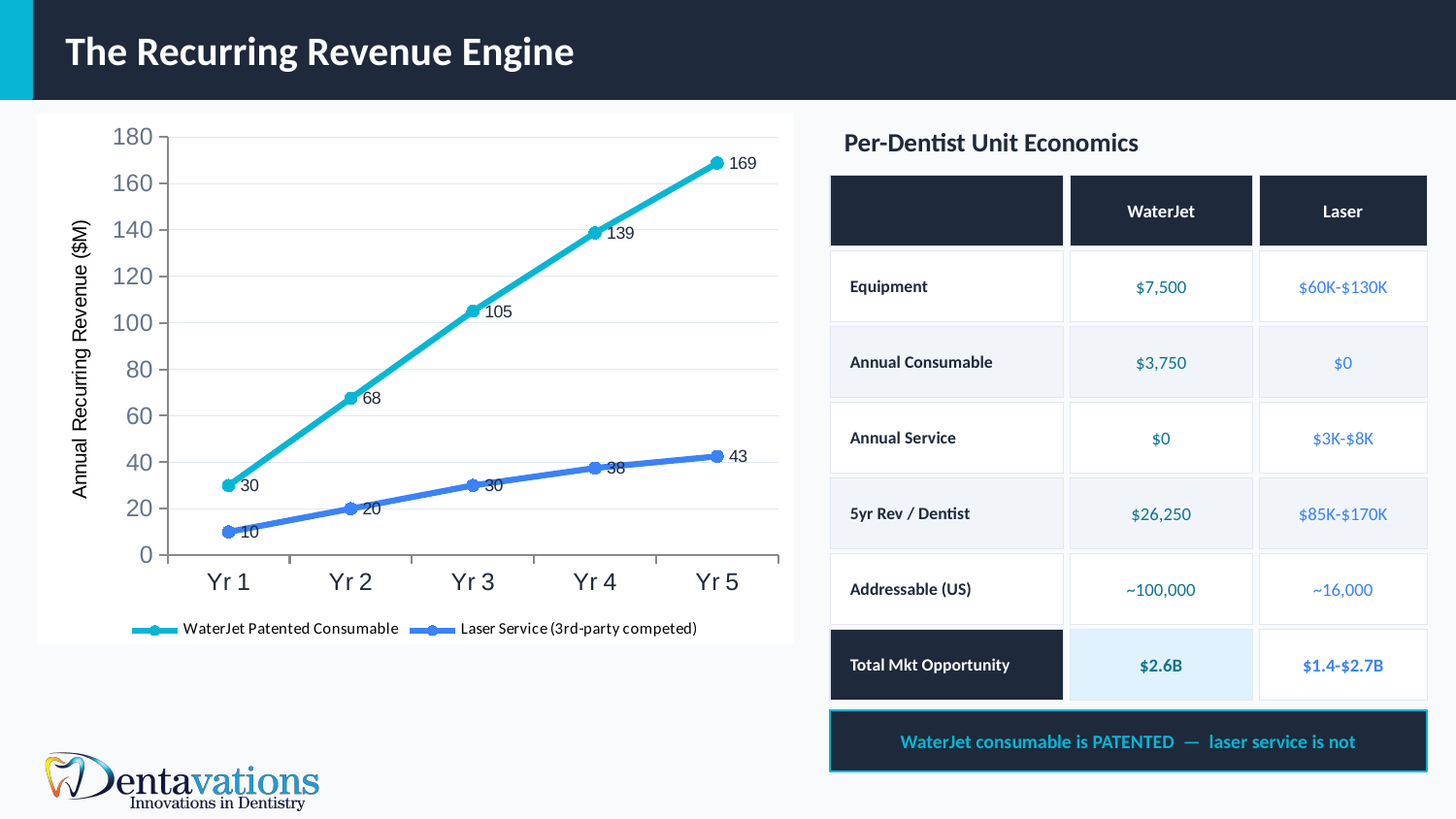
How many series does the chart legend list? 2 What is the value for WaterJet Patented Consumable in Yr 5? 169 In which year is the WaterJet Patented Consumable series highest? Yr 5 What is the label of the y axis of the chart? Annual Recurring Revenue ($M) Does the WaterJet Patented Consumable series rise or fall from Yr 1 to Yr 5? Rise Which series has the larger value in Yr 2, WaterJet Patented Consumable or Laser Service (3rd-party competed)? WaterJet Patented Consumable What is the value for Laser Service (3rd-party competed) in Yr 4? 38 What is the difference between WaterJet Patented Consumable and Laser Service (3rd-party competed) in Yr 5? 126 What kind of chart is shown on the slide? Line chart In which year is the Laser Service (3rd-party competed) series lowest? Yr 1 What is the value for WaterJet Patented Consumable in Yr 3? 105 How many years are shown on the x axis of the chart? 5